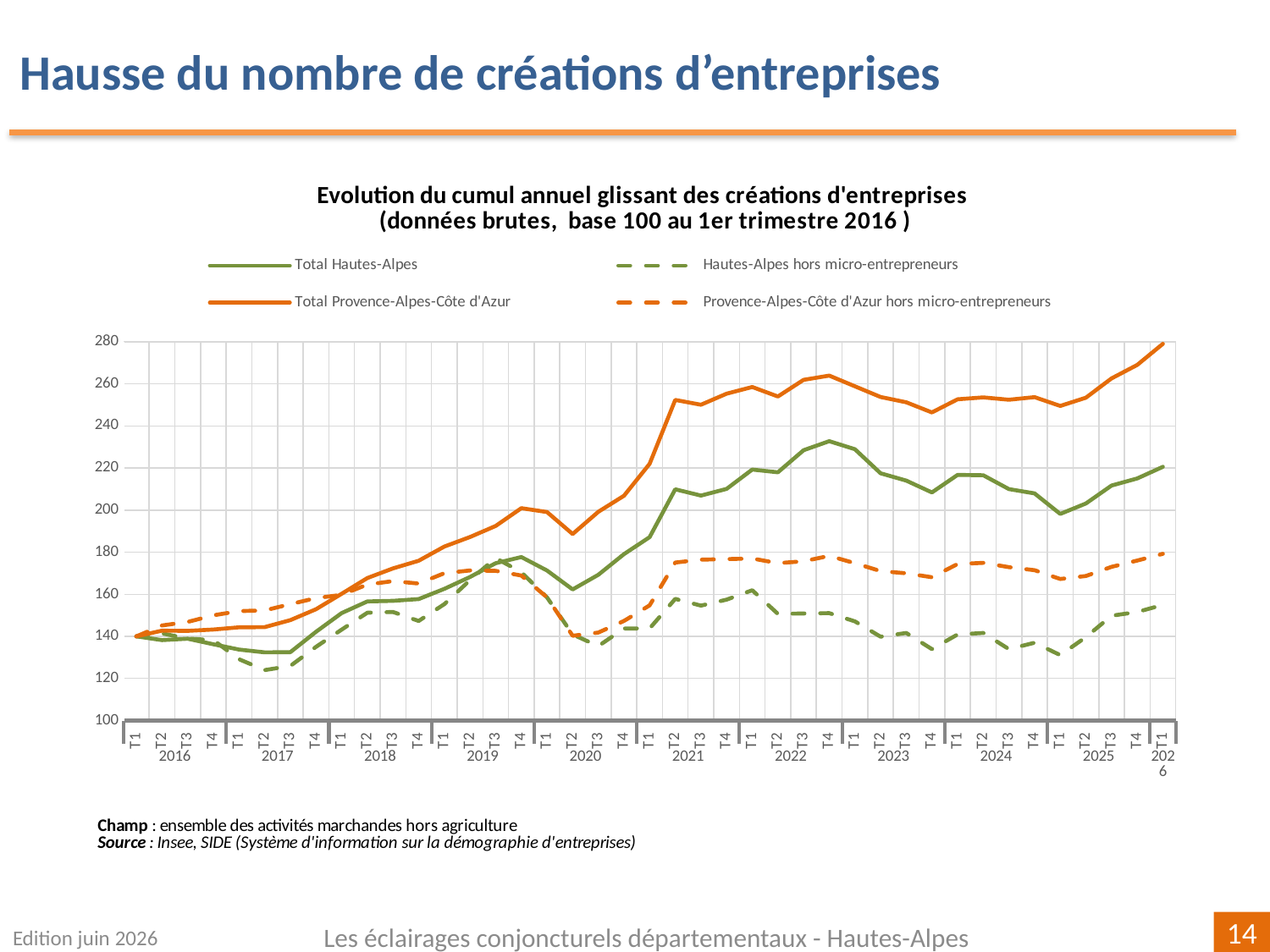
At T1 2026, which is larger: Total Provence-Alpes-Côte d'Azur or Total Hautes-Alpes? Total Provence-Alpes-Côte d'Azur What is the title of the chart? Evolution du cumul annuel glissant des créations d'entreprises (données brutes, base 100 au 1er trimestre 2016 ) Which series is drawn as a solid orange line? Total Provence-Alpes-Côte d'Azur Is the value of Total Provence-Alpes-Côte d'Azur at T1 2026 greater or less than 260? greater Does the Total Provence-Alpes-Côte d'Azur series rise or fall overall from T1 2016 to T1 2026? rise Is the value of Total Hautes-Alpes at T1 2026 greater or less than 200? greater Which series has the highest value at T1 2026? Total Provence-Alpes-Côte d'Azur What kind of chart is shown on the slide? line chart How many series does the legend list? 4 Which series has the lowest value at T1 2026? Hautes-Alpes hors micro-entrepreneurs How many year labels appear on the x axis? 11 Is the value of Hautes-Alpes hors micro-entrepreneurs at T2 2017 greater or less than 140? less